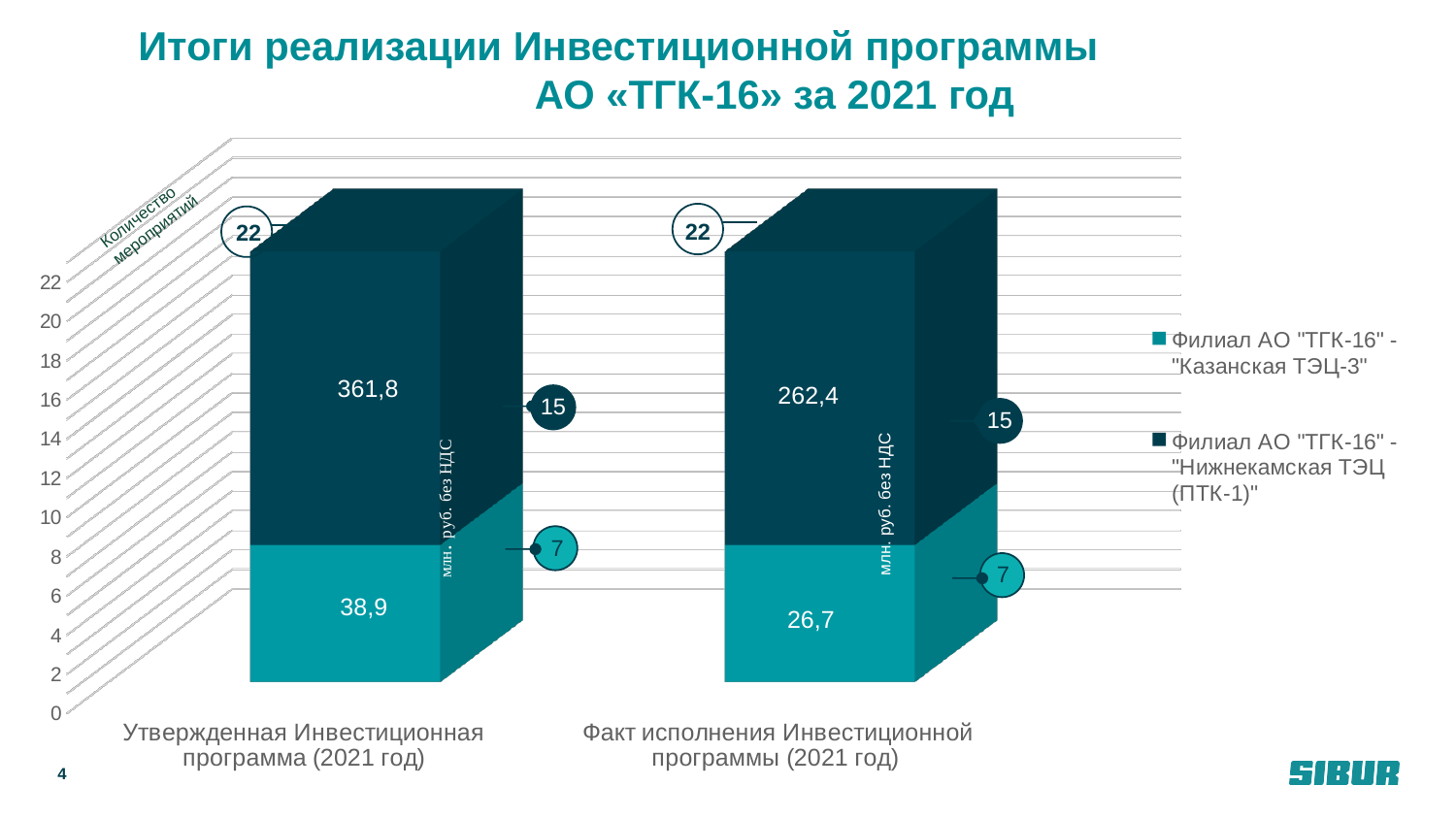
What unit is written on the bars for the data labels? млн. руб. без НДС What is the value labelled for Филиал АО "ТГК-16" - "Казанская ТЭЦ-3" in the Утвержденная Инвестиционная программа (2021 год) bar? 38,9 What is the sum of the two data labels (38,9 and 361,8) on the Утвержденная Инвестиционная программа (2021 год) bar? 400,7 How many categories are shown on the x axis? 2 What type of chart is shown on the slide? stacked bar chart What is the difference between the Нижнекамская ТЭЦ (ПТК-1) values for the approved programme (361,8) and the actual execution (262,4)? 99,4 What is the value labelled for Филиал АО "ТГК-16" - "Нижнекамская ТЭЦ (ПТК-1)" in the Факт исполнения Инвестиционной программы (2021 год) bar? 262,4 What is the value labelled for Филиал АО "ТГК-16" - "Нижнекамская ТЭЦ (ПТК-1)" in the Утвержденная Инвестиционная программа (2021 год) bar? 361,8 Which is larger: the Казанская ТЭЦ-3 value for the approved programme or for the actual execution? approved programme (38,9) How many мероприятий (events) are shown in the circle at the top of each bar? 22 What is the value labelled for Филиал АО "ТГК-16" - "Казанская ТЭЦ-3" in the Факт исполнения Инвестиционной программы (2021 год) bar? 26,7 How many series does the legend list? 2